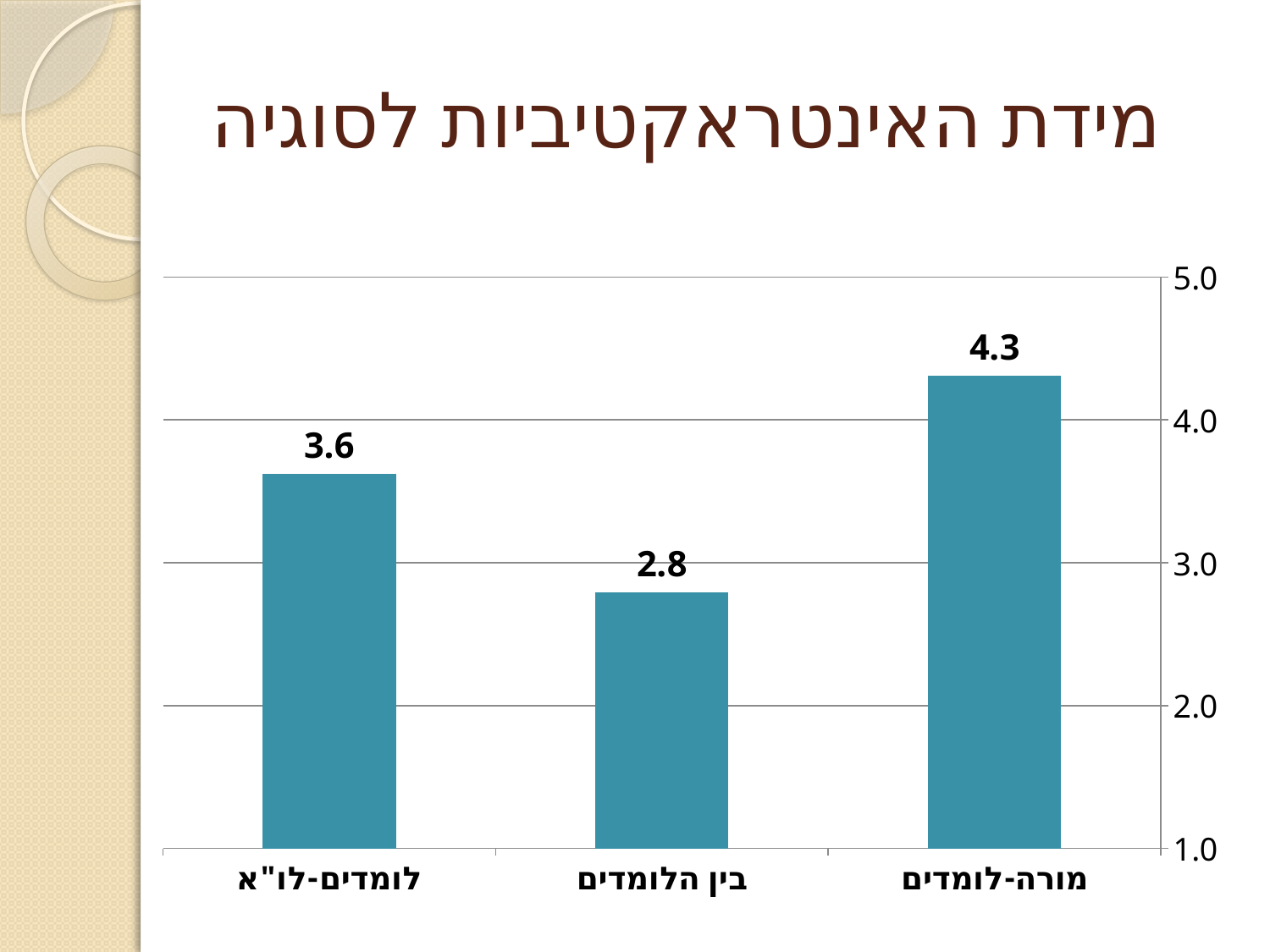
What is the value for מורה-לומדים? 4.3 Which is larger, the value for לומדים-לו"א or the value for מורה-לומדים? מורה-לומדים What is the value for בין הלומדים? 2.8 What kind of chart is shown on the slide? bar chart How many categories are shown on the chart? 3 Which category has the highest value? מורה-לומדים What is the difference between the values for לומדים-לו"א and בין הלומדים? 0.8 What is the difference between the values for מורה-לומדים and בין הלומדים? 1.5 What is the value for לומדים-לו"א? 3.6 Which category has the lowest value? בין הלומדים What is the title of the slide? מידת האינטראקטיביות לסוגיה Is the value for בין הלומדים greater or less than 3.0? less